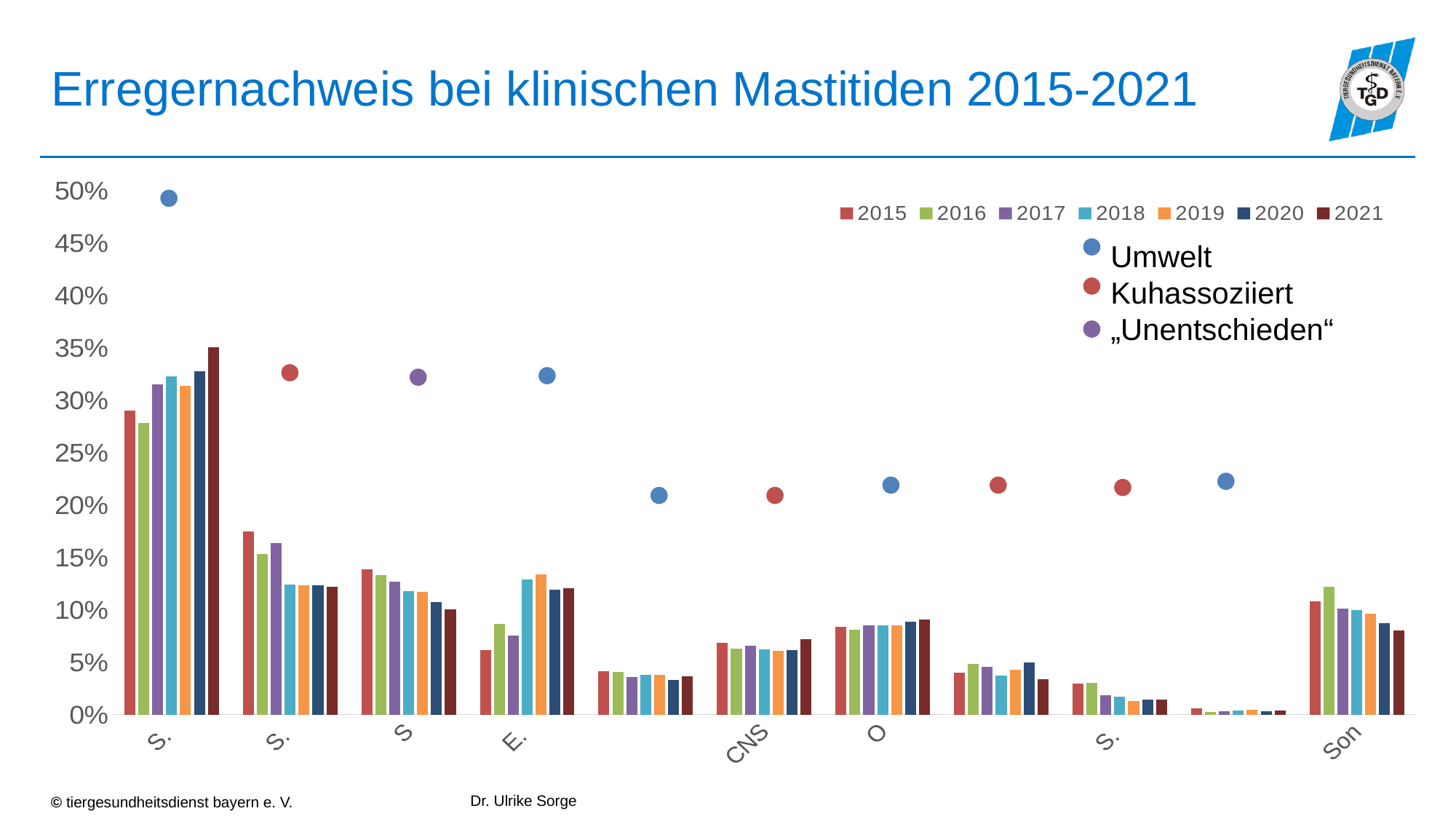
Is the 2021 value for O greater or less than 10%? less Is the 2021 value for CNS greater or less than 5%? greater Is the 2016 value for Son greater or less than 10%? greater What is the title of the chart? Erregernachweis bei klinischen Mastitiden 2015-2021 What kind of chart is shown on the slide? bar chart In the Son group, is the 2015 value or the 2021 value larger? 2015 How many groups of bars are plotted along the x axis? 11 Which year has the highest value in the Son group? 2016 Which three classifications are listed in the dot legend? Umwelt, Kuhassoziiert, "Unentschieden" Which year has the lowest value in the E. group? 2015 How many years does the bar legend list? 7